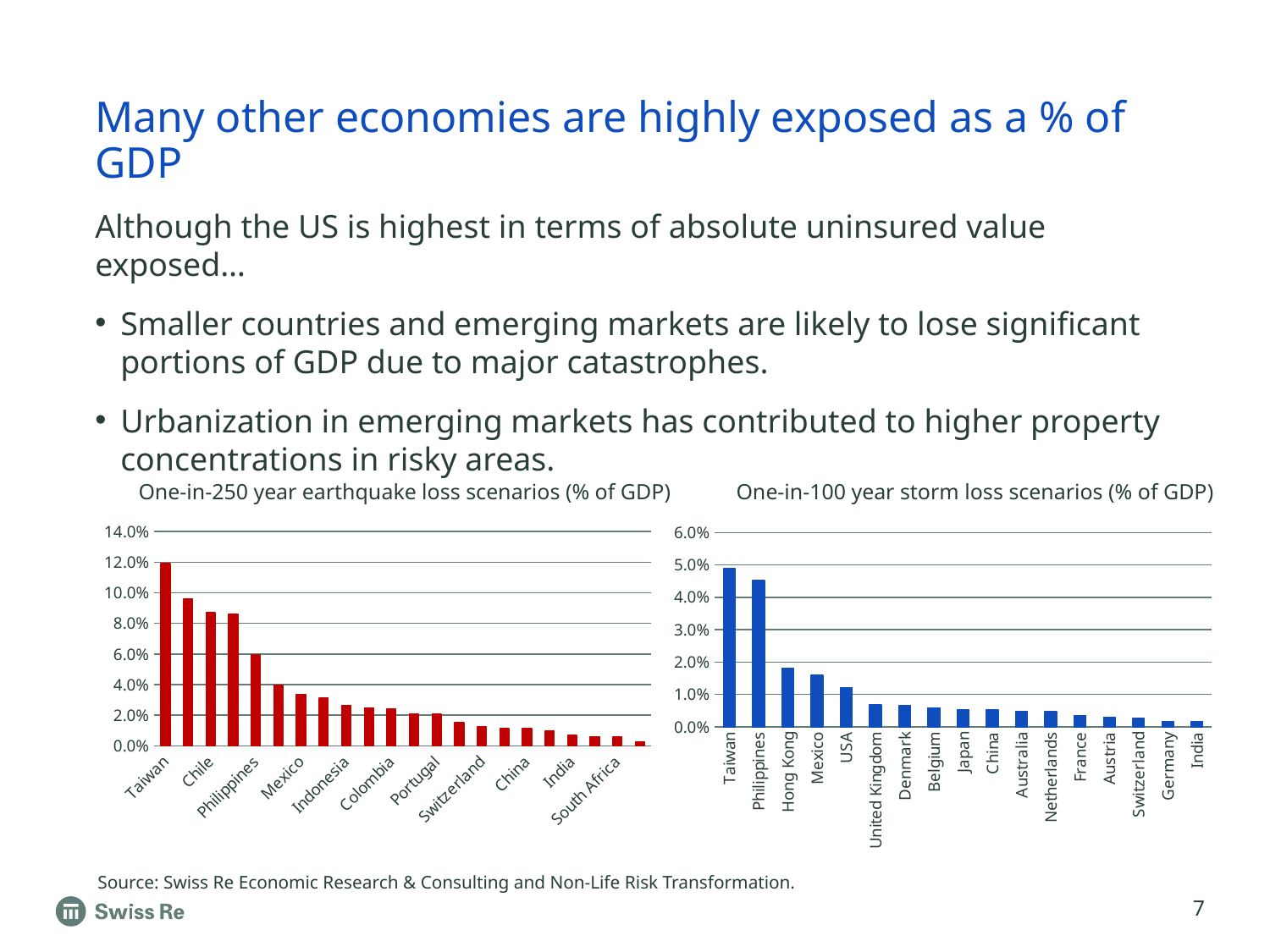
In the 'One-in-250 year earthquake loss scenarios (% of GDP)' chart, is the value for China greater or less than 2.0%? less In the 'One-in-100 year storm loss scenarios (% of GDP)' chart, which country has the highest value? Taiwan How many countries are shown in the 'One-in-100 year storm loss scenarios (% of GDP)' chart? 17 In the 'One-in-100 year storm loss scenarios (% of GDP)' chart, is the value for Philippines greater or less than 4.0%? greater What colour are the bars in the 'One-in-100 year storm loss scenarios (% of GDP)' chart? blue In the 'One-in-250 year earthquake loss scenarios (% of GDP)' chart, is the value for Chile greater or less than 6.0%? greater What type of chart is the 'One-in-250 year earthquake loss scenarios (% of GDP)' chart? bar chart In the 'One-in-250 year earthquake loss scenarios (% of GDP)' chart, which is larger, the value for Taiwan or the value for Mexico? Taiwan In the 'One-in-250 year earthquake loss scenarios (% of GDP)' chart, which country has the highest value? Taiwan In the 'One-in-100 year storm loss scenarios (% of GDP)' chart, which is larger, the value for Hong Kong or the value for France? Hong Kong